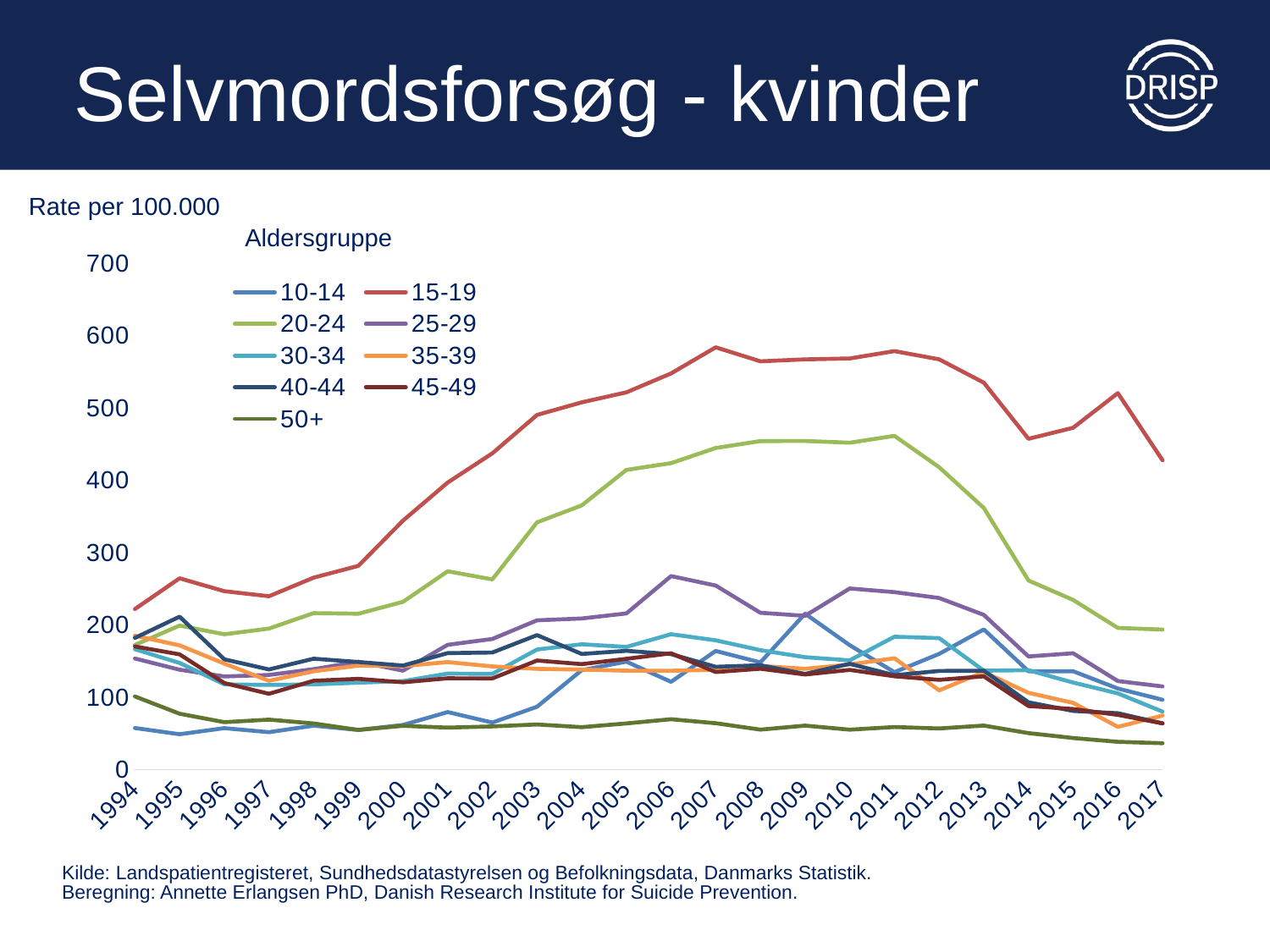
How many years are shown along the x axis? 24 Is the value for the 15-19 age group in 2007 greater or less than 500? greater Does the rate for the 20-24 age group rise or fall from 2011 to 2017? fall What is the label shown above the y axis of the chart? Rate per 100.000 What kind of chart is shown on the slide? line chart Is the value for the 20-24 age group in 2017 greater or less than 300? less Does the rate for the 15-19 age group rise or fall from 1994 to 2007? rise Is the value for the 50+ age group in 2017 greater or less than 100? less Which age group has the lowest rate in 2017? 50+ How many age groups does the legend list? 9 Which is larger in 2010, the rate for 15-19 or the rate for 20-24? 15-19 Which age group has the highest rate in 2007? 15-19